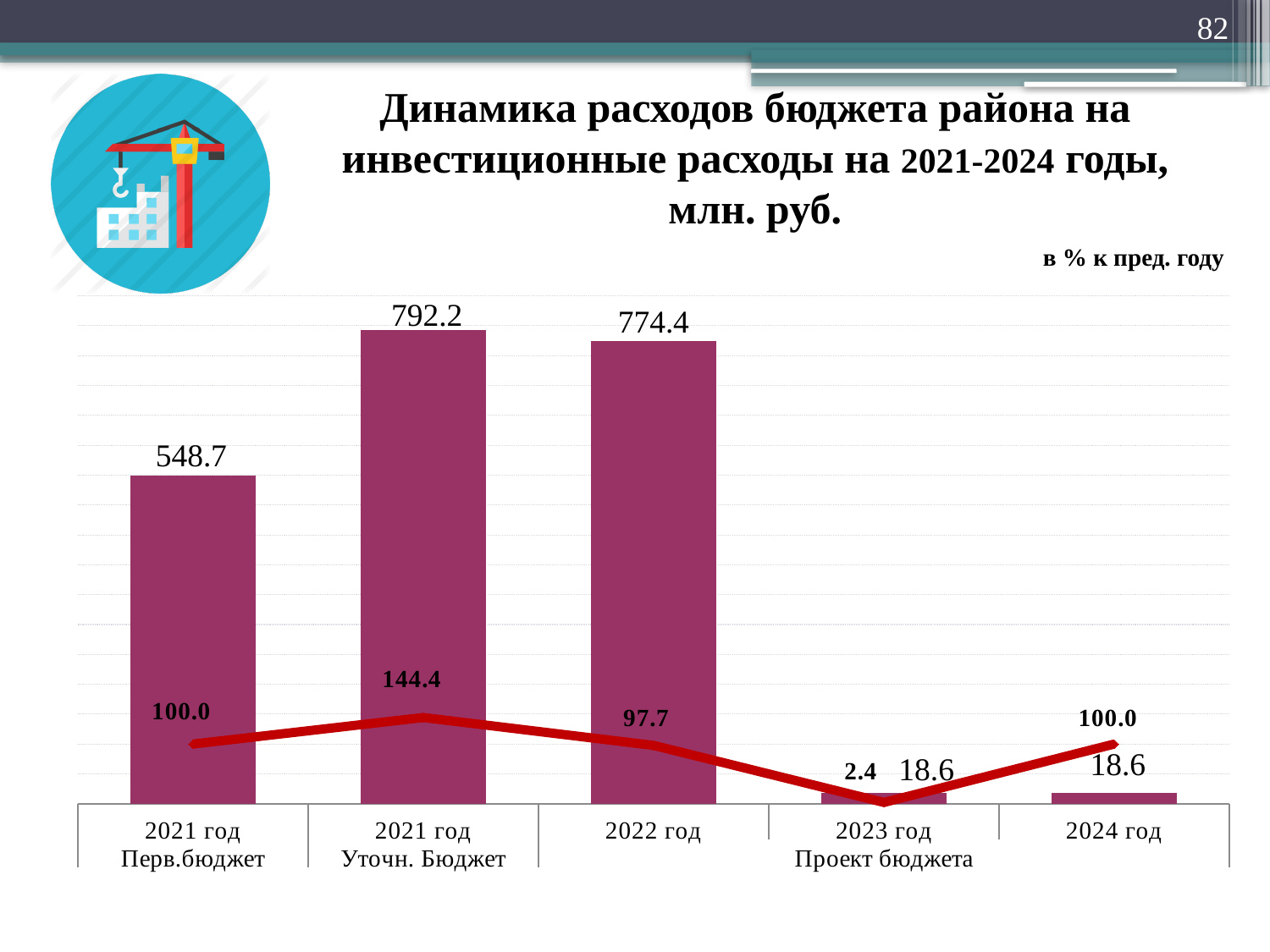
What is the bar value for 2021 год Перв.бюджет? 548.7 Which category has the highest bar? 2021 год Уточн. Бюджет What is the value of the red line (в % к пред. году) for 2021 год Уточн. Бюджет? 144.4 How many categories are shown on the x axis? 5 What is the bar value for 2021 год Уточн. Бюджет? 792.2 What kind of chart is shown on the slide? Combined bar and line chart Which category has the lowest value on the red line (в % к пред. году)? 2023 год What is the title of the chart? Динамика расходов бюджета района на инвестиционные расходы на 2021-2024 годы, млн. руб. What is the bar value for 2022 год? 774.4 What is the value of the red line (в % к пред. году) for 2023 год? 2.4 What is the difference between the bar values for 2021 год Уточн. Бюджет and 2021 год Перв.бюджет? 243.5 Which bar is larger: 2022 год or 2021 год Перв.бюджет? 2022 год